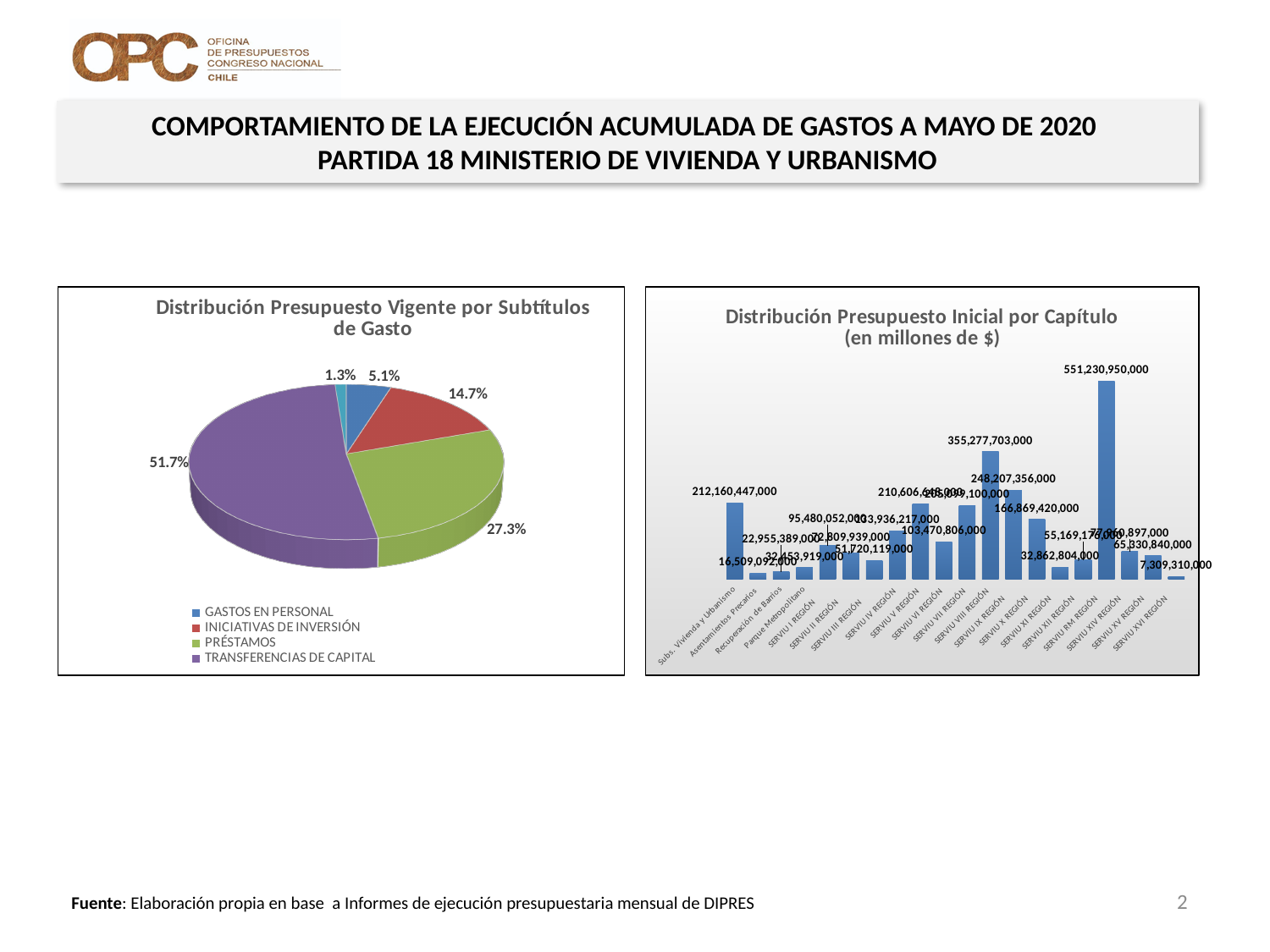
In the 'Distribución Presupuesto Vigente por Subtítulos de Gasto' pie chart, what share does PRÉSTAMOS have? 27.3% In the 'Distribución Presupuesto Inicial por Capítulo' chart, what is the value for SERVIU VIII REGIÓN? 355,277,703,000 In the 'Distribución Presupuesto Vigente por Subtítulos de Gasto' pie chart, what share does GASTOS EN PERSONAL have? 5.1% In the 'Distribución Presupuesto Vigente por Subtítulos de Gasto' pie chart, what share does TRANSFERENCIAS DE CAPITAL have? 51.7% What kind of chart is the 'Distribución Presupuesto Vigente por Subtítulos de Gasto' chart on the left? Pie chart How many entries does the legend of the 'Distribución Presupuesto Vigente por Subtítulos de Gasto' chart list? 4 What kind of chart is the 'Distribución Presupuesto Inicial por Capítulo' chart on the right? Bar chart In the 'Distribución Presupuesto Inicial por Capítulo' chart, which capítulo has the lowest value? SERVIU XVI REGIÓN In the 'Distribución Presupuesto Vigente por Subtítulos de Gasto' pie chart, which legend category has the largest slice? TRANSFERENCIAS DE CAPITAL In the 'Distribución Presupuesto Inicial por Capítulo' chart, what is the difference between the values for SERVIU RM REGIÓN and SERVIU VIII REGIÓN? 195,953,247,000 In the 'Distribución Presupuesto Inicial por Capítulo' chart, which is larger: SERVIU IX REGIÓN or SERVIU X REGIÓN? SERVIU IX REGIÓN In the 'Distribución Presupuesto Inicial por Capítulo' chart, which capítulo has the highest value? SERVIU RM REGIÓN